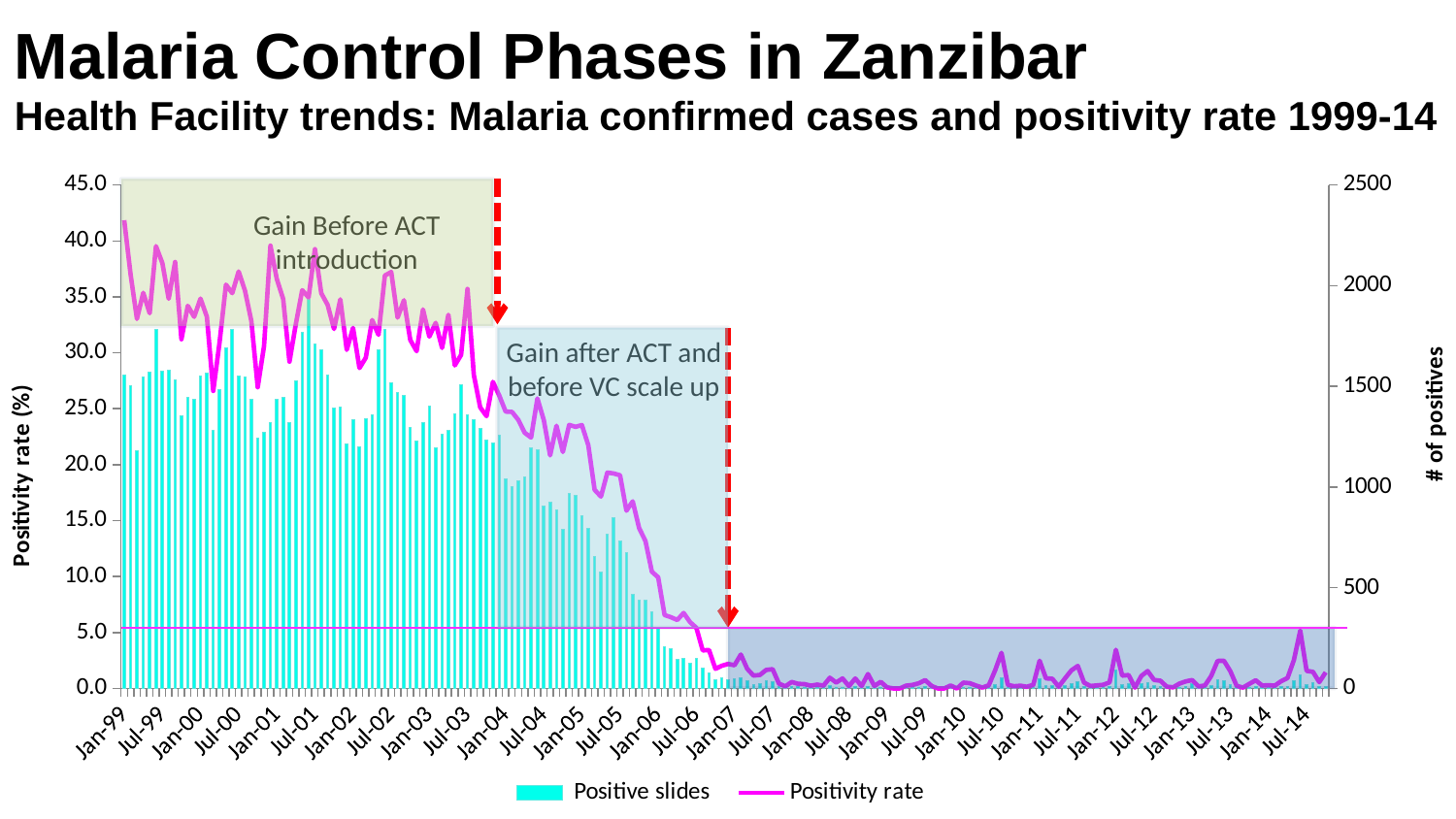
Is the positivity rate at Jul-14 greater or less than 10.0? less What kind of chart is shown on the slide? A combined bar and line chart Is the number of positive slides at Jan-99 greater or less than 1000? greater Is the positivity rate higher at Jan-99 or at Jan-07? Jan-99 What is the label of the left vertical axis? Positivity rate (%) How many series does the legend list? 2 Is the number of positive slides at Jan-10 greater or less than 500? less Are there more positive slides at Jul-01 or at Jul-08? Jul-01 Does the positivity rate overall rise or fall from Jan-99 to Jul-14? Fall Which series is drawn as bars? Positive slides